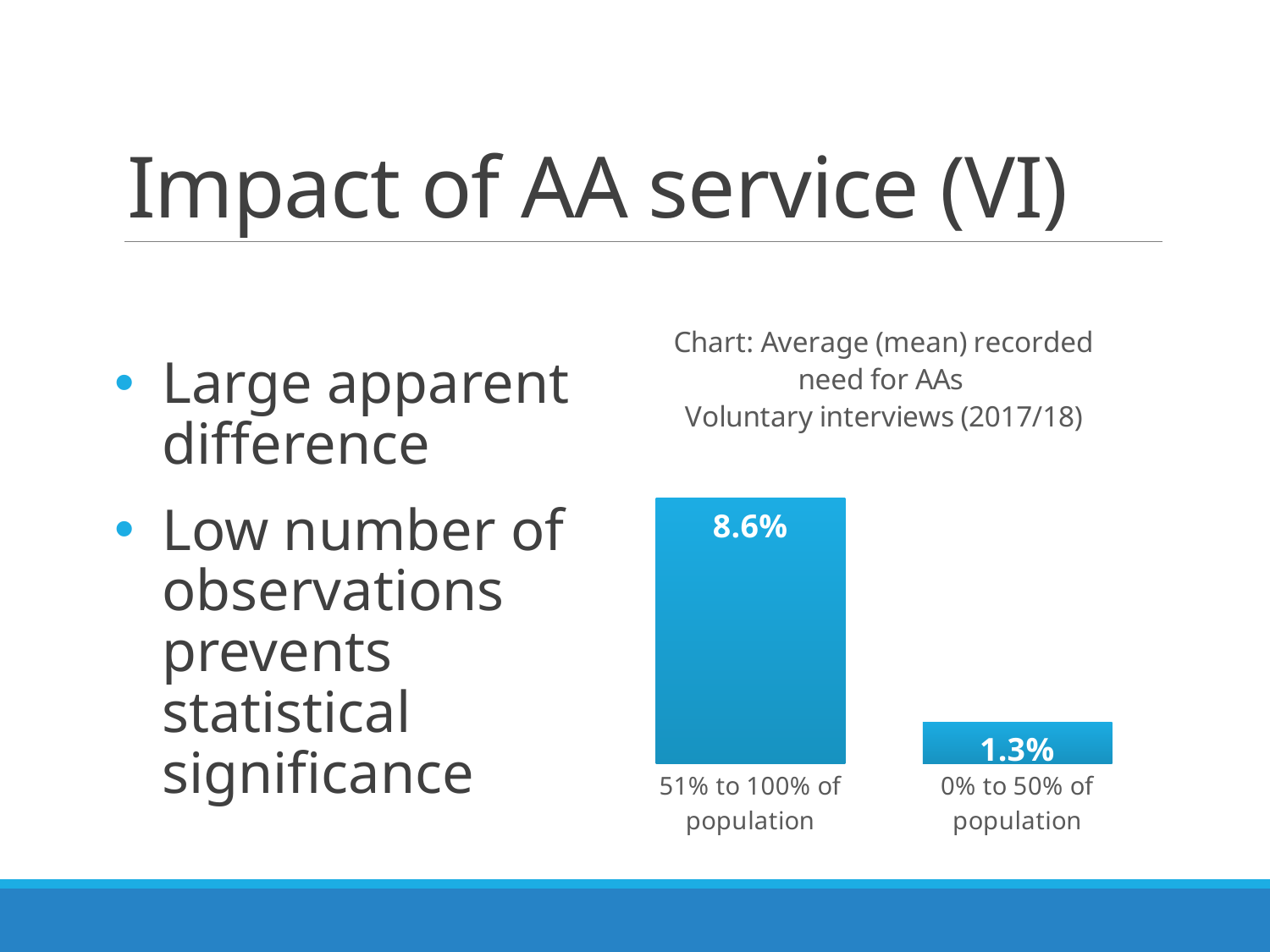
How many categories are shown in the chart? 2 Which category has the highest value? 51% to 100% of population What is the title of the chart? Chart: Average (mean) recorded need for AAs Voluntary interviews (2017/18) Which is larger: the value for "51% to 100% of population" or the value for "0% to 50% of population"? 51% to 100% of population Do the values rise or fall from left to right across the categories? Fall What is the value for "0% to 50% of population"? 1.3% Which category has the lowest value? 0% to 50% of population What is the difference between the values for "51% to 100% of population" and "0% to 50% of population"? 7.3% What colour are the bars in the chart? Blue What is the value for "51% to 100% of population"? 8.6% What kind of chart is shown on the slide? Bar chart